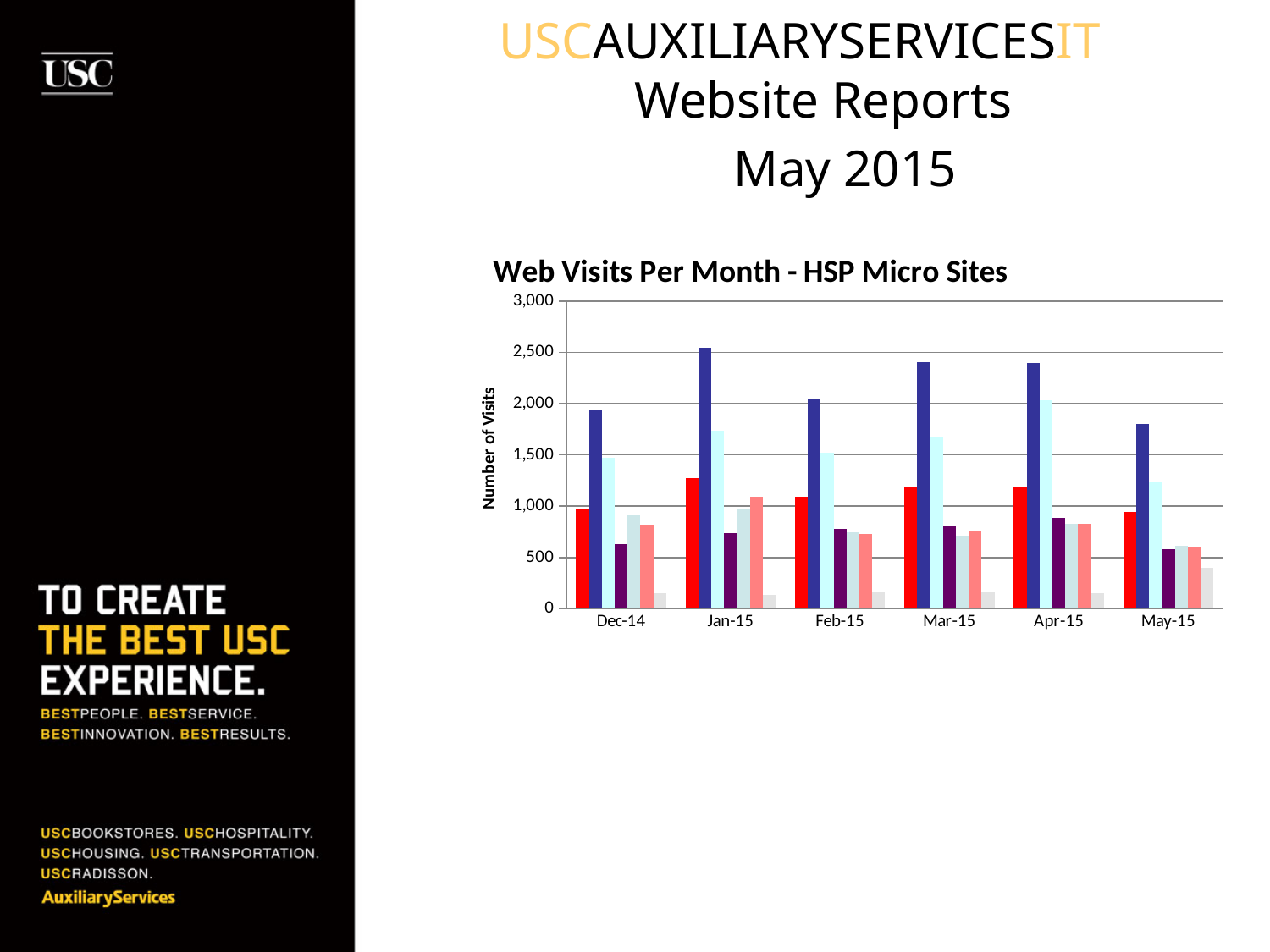
How many months are shown along the x axis of the chart? 6 In which month is the light cyan bar the tallest? Apr-15 Is the dark blue bar for May-15 greater or less than 2,000? less Is the dark blue bar for Jan-15 greater or less than 2,000? greater In which month is the dark blue bar the tallest? Jan-15 What is the title of the chart? Web Visits Per Month - HSP Micro Sites Which month has the larger dark blue bar, Jan-15 or May-15? Jan-15 Is the light cyan bar for May-15 greater or less than 1,500? less What kind of chart is shown on the slide? bar chart What is the label on the vertical axis of the chart? Number of Visits